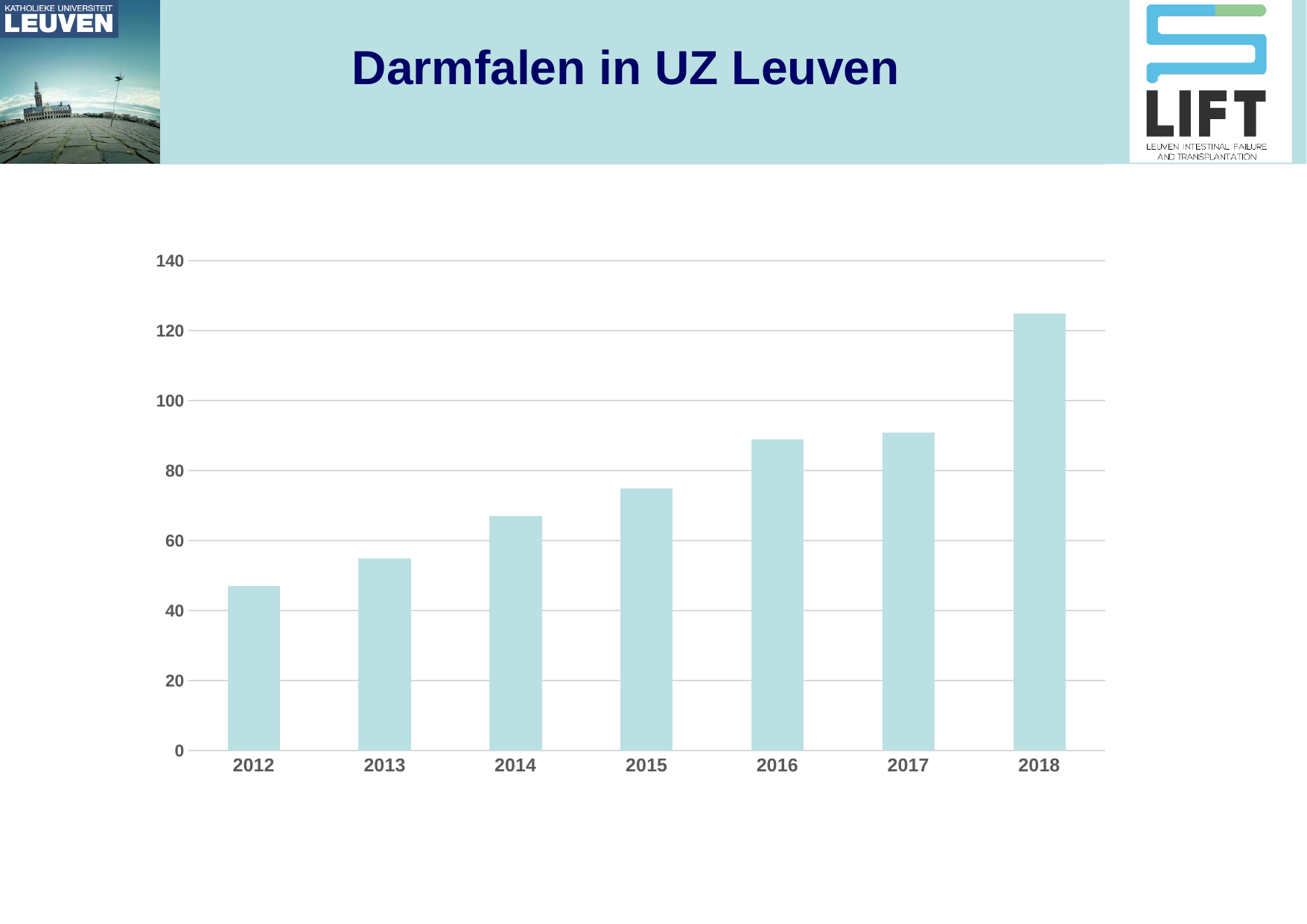
Which is larger, the value for 2013 or the value for 2015? 2015 Is the value for 2015 greater or less than 80? less Is the value for 2018 greater or less than 120? greater What kind of chart is shown on the slide? bar chart What is the title of the slide containing the chart? Darmfalen in UZ Leuven Do the values rise or fall from 2012 to 2018? rise Is the value for 2016 greater or less than 80? greater How many years are shown on the x axis of the chart? 7 Which year has the lowest bar in the chart? 2012 Which year has the highest bar in the chart? 2018